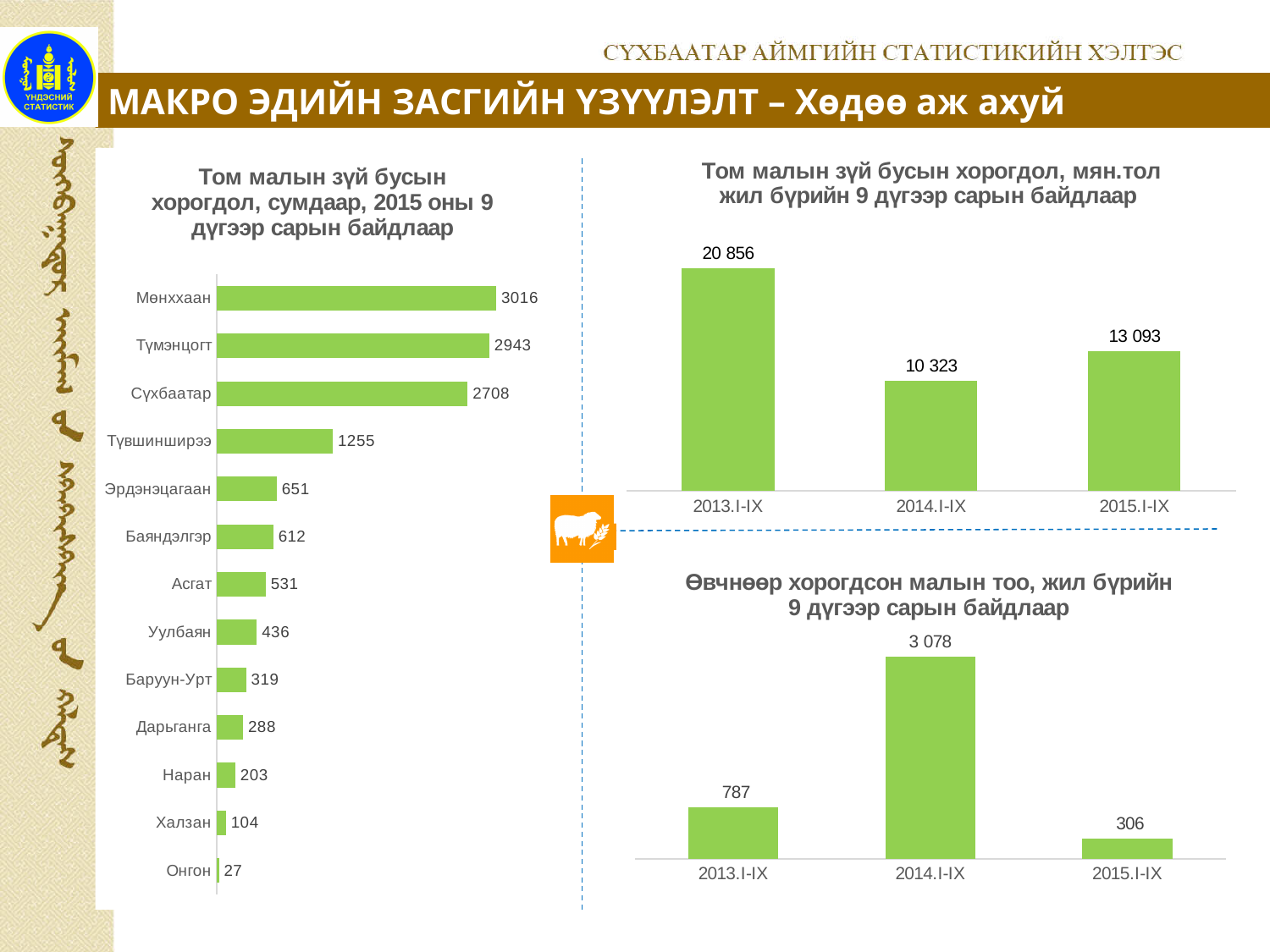
What type of chart is the bottom right chart (Өвчнөөр хорогдсон малын тоо)? Bar chart In the bottom right chart (Өвчнөөр хорогдсон малын тоо), what is the value for 2013.I-IX? 787 In the top right chart (Том малын зүй бусын хорогдол, мян.тол), what is the difference between the values for 2015.I-IX and 2014.I-IX? 2 770 In the top right chart (Том малын зүй бусын хорогдол, мян.тол), what is the value for 2014.I-IX? 10 323 In the bottom right chart (Өвчнөөр хорогдсон малын тоо), which year has the lowest value? 2015.I-IX In the left chart (Том малын зүй бусын хорогдол, сумдаар), which sum has the highest value? Мөнххаан In the left chart (Том малын зүй бусын хорогдол, сумдаар), which is larger, the value for Баяндэлгэр or the value for Асгат? Баяндэлгэр In the top right chart (Том малын зүй бусын хорогдол, мян.тол), which year has the highest value? 2013.I-IX In the left chart (Том малын зүй бусын хорогдол, сумдаар), how many sums are shown? 13 In the left chart (Том малын зүй бусын хорогдол, сумдаар), what is the value for Сүхбаатар? 2708 In the left chart (Том малын зүй бусын хорогдол, сумдаар), what is the difference between the values for Мөнххаан and Түмэнцогт? 73 In the left chart (Том малын зүй бусын хорогдол, сумдаар), which sum has the lowest value? Онгон